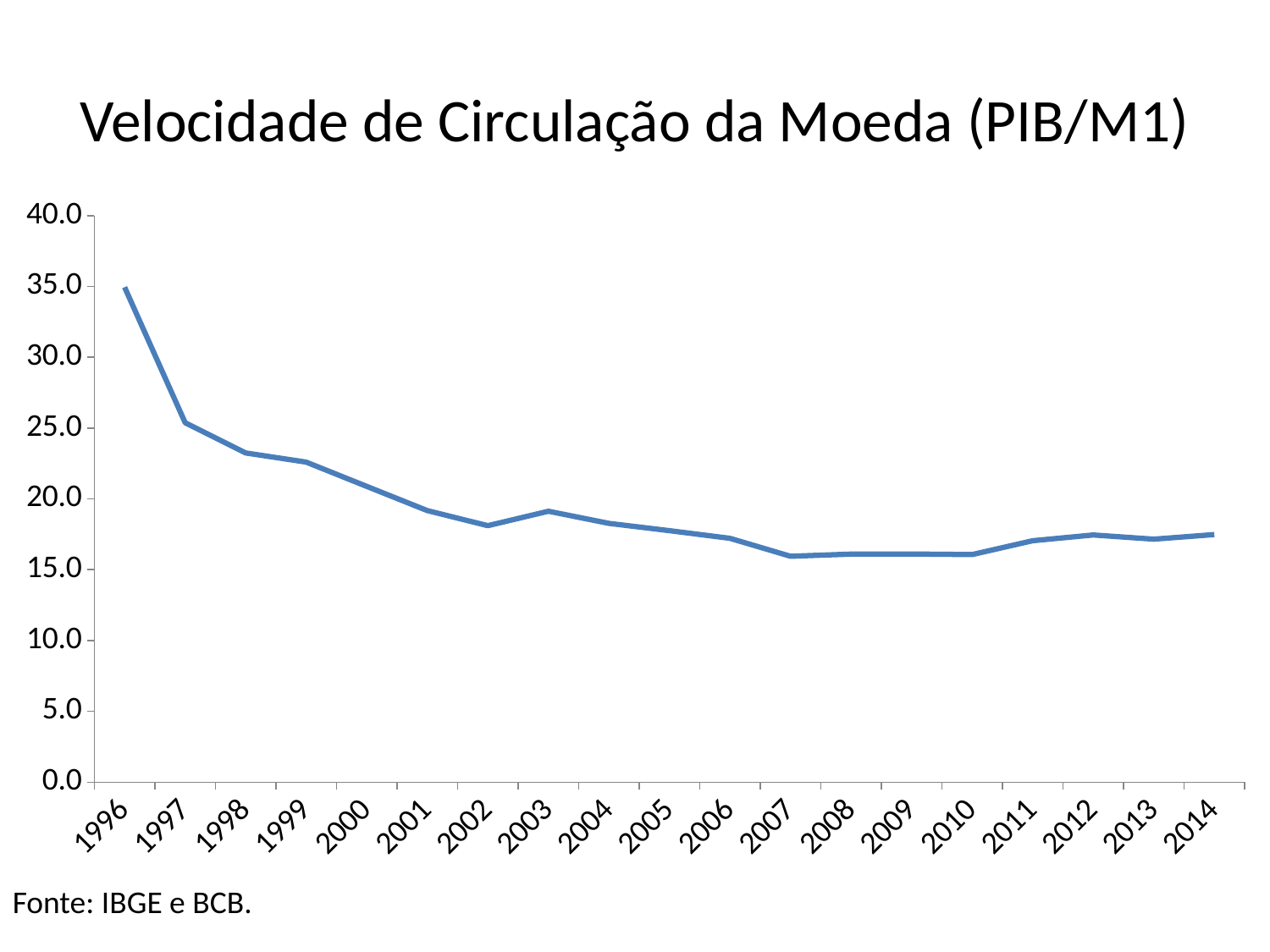
Overall, do the values rise or fall from 1996 to 2014? fall What kind of chart is shown on the slide? line chart Which is larger, the value for 2002 or the value for 2003? 2003 Is the value for 2014 greater or less than 20.0? less What is the title of the chart? Velocidade de Circulação da Moeda (PIB/M1) How many years are plotted along the x axis? 19 What source is cited below the chart? IBGE e BCB Is the value for 1996 greater or less than 30.0? greater Is the value for 2002 greater or less than 20.0? less Which year has the highest value? 1996 Which is larger, the value for 1998 or the value for 2003? 1998